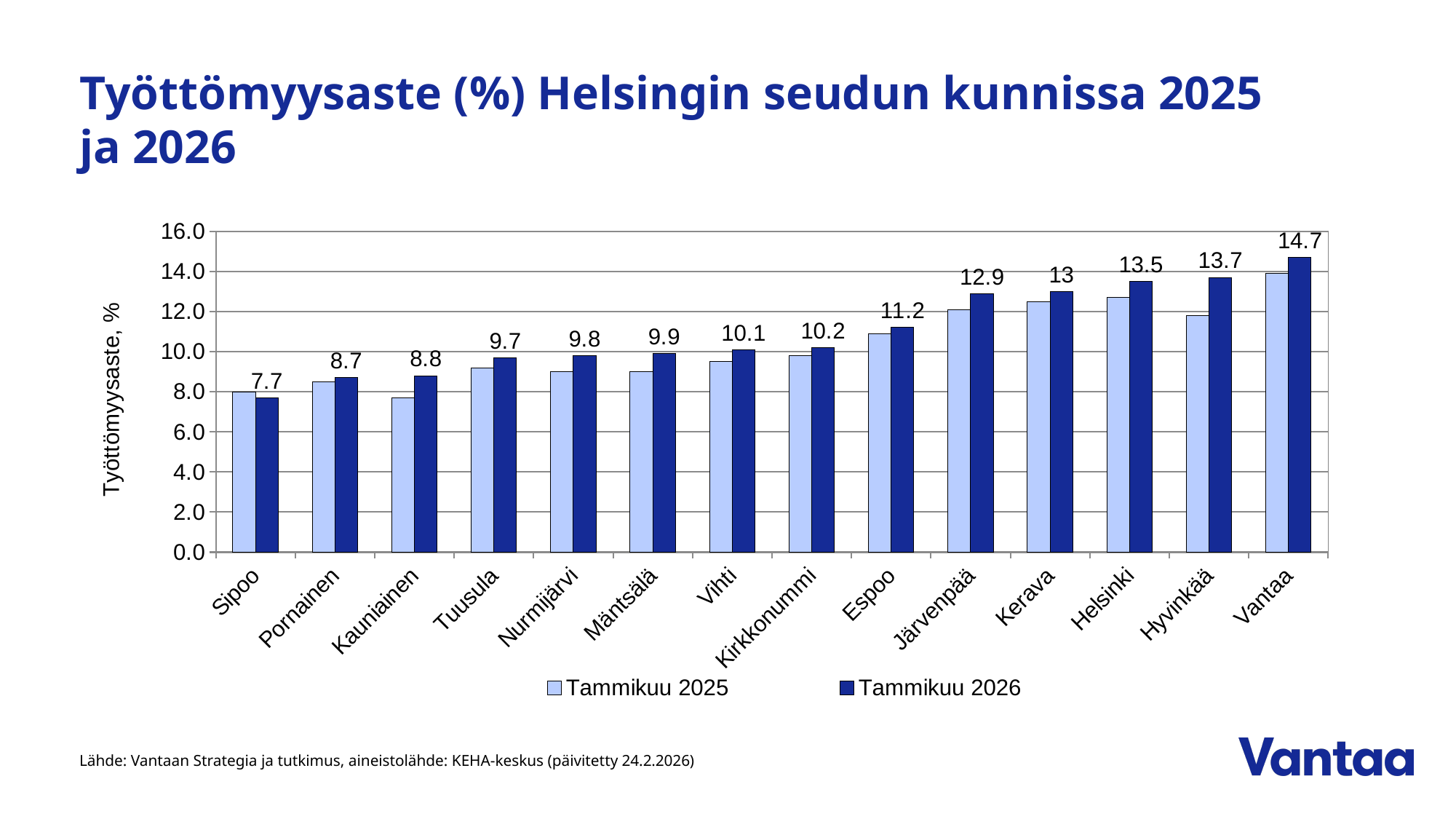
Is the Tammikuu 2025 value for Helsinki greater or less than 12.0? greater What is the Tammikuu 2026 unemployment rate for Vantaa? 14.7 Which municipality has the highest Tammikuu 2026 unemployment rate? Vantaa How many series does the legend list? 2 What kind of chart is shown on the slide? Bar chart Which municipality has the lowest Tammikuu 2026 unemployment rate? Sipoo What is the Tammikuu 2026 value for Kerava? 13 What is the Tammikuu 2026 value for Kirkkonummi? 10.2 How many municipalities are shown on the x axis? 14 Which has the higher Tammikuu 2026 value, Helsinki or Kerava? Helsinki What is the difference between the Tammikuu 2026 values for Vantaa and Hyvinkää? 1.0